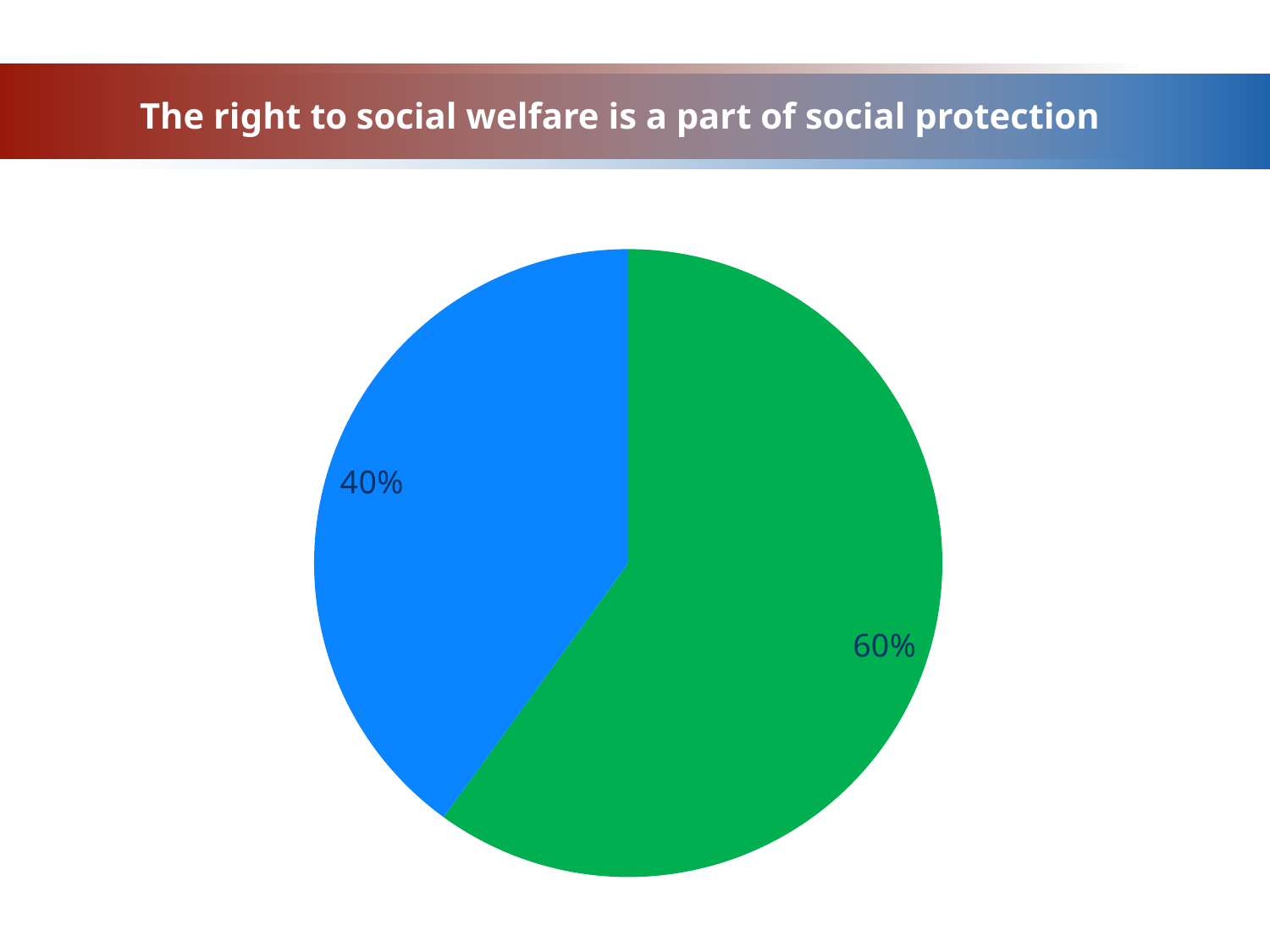
What is the difference in percentage points between the green slice and the blue slice? 20 percentage points What share of the pie does the blue slice represent? 40% What percentage is shown on the blue slice of the pie chart? 40% What is the title shown in the banner above the chart? The right to social welfare is a part of social protection What kind of chart is shown on the slide? pie chart What percentage is shown on the green slice of the pie chart? 60% Which is larger, the green slice or the blue slice? the green slice Which slice of the pie chart is the smallest? the blue slice (40%) How many slices does the pie chart have? 2 Which slice of the pie chart is the largest? the green slice (60%) What share of the pie does the green slice represent? 60% What two colours are used for the slices of the pie chart? green and blue